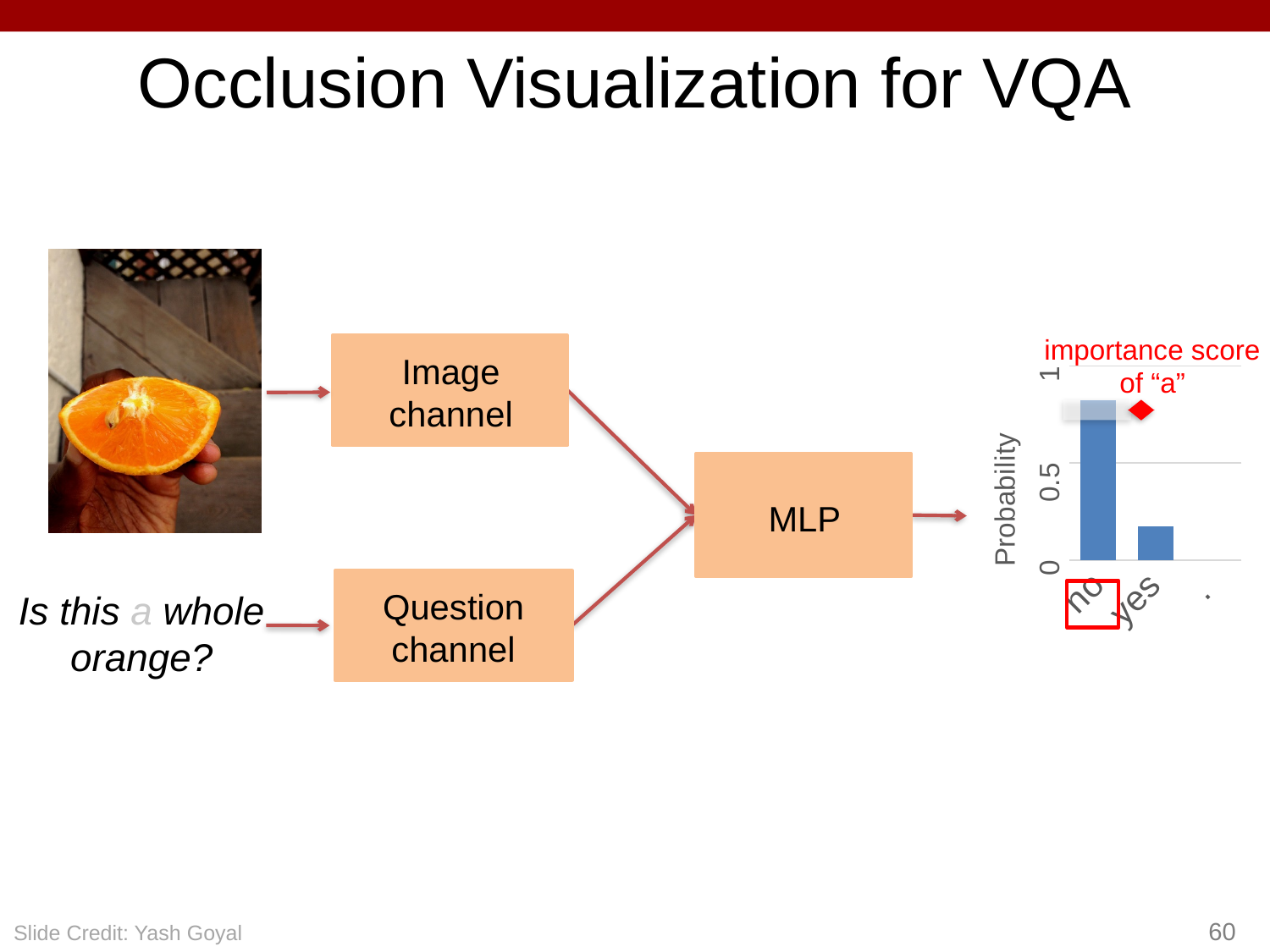
What is the label of the y axis of the bar chart? Probability Which has a larger probability in the bar chart, "no" or "yes"? no Which category has the highest probability in the bar chart? no Is the probability for "yes" greater or less than 0.5? less What does the red diamond marker on the bar chart represent? importance score of "a" What kind of chart is shown on the right of the slide? bar chart Which category has the lowest probability in the bar chart? yes Is the probability for "no" greater or less than 0.5? greater